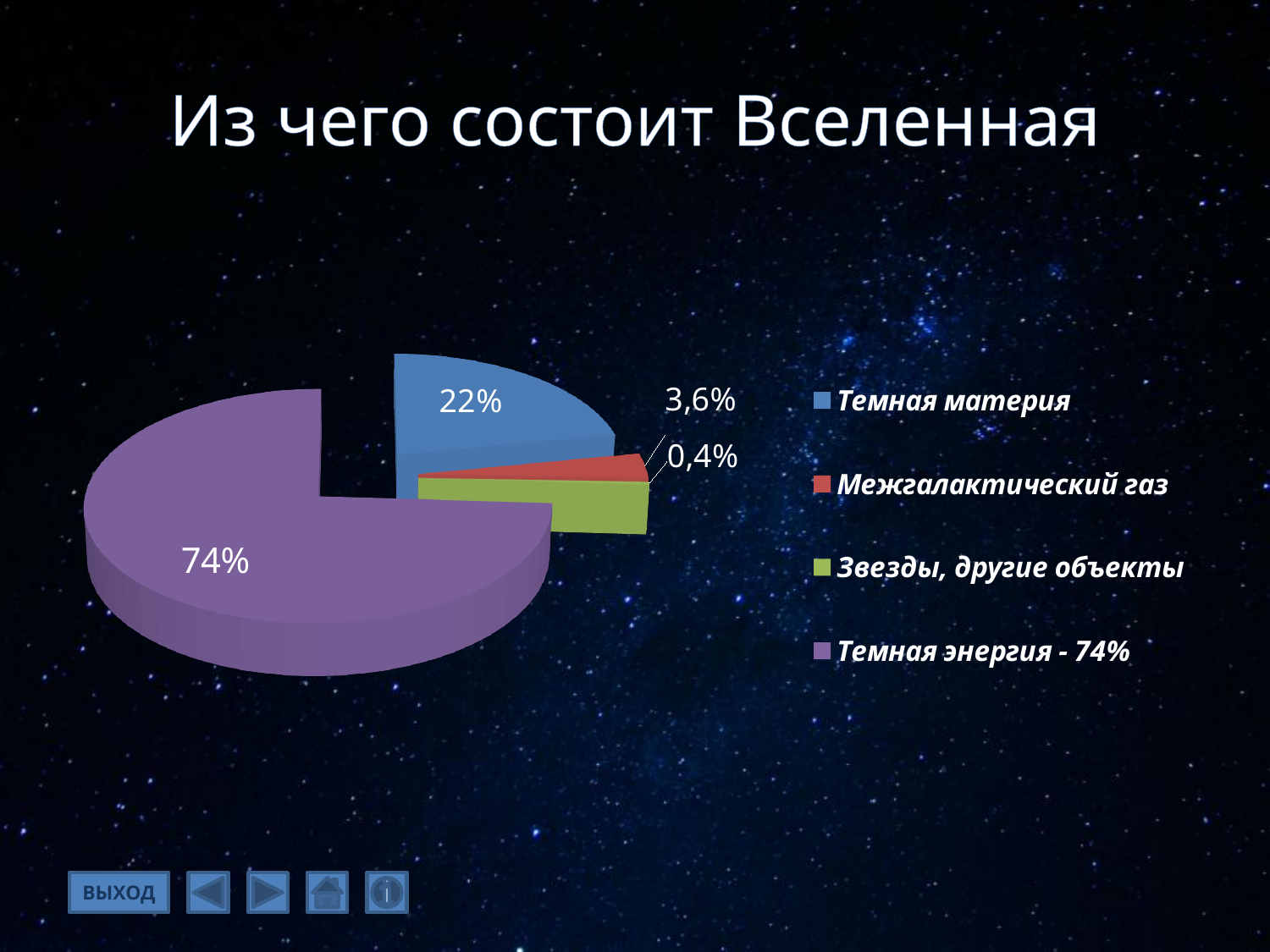
What kind of chart is shown on the slide? pie chart What share of the pie does Темная энергия take? 74% What is the difference between the values for Темная энергия and Темная материя? 52% What is the value shown for Темная материя? 22% Which category has the smallest slice of the pie? Звезды, другие объекты Which is larger, Темная материя or Межгалактический газ? Темная материя What is the title of the slide? Из чего состоит Вселенная Which category has the largest slice of the pie? Темная энергия What is the value shown for Звезды, другие объекты? 0,4% What colour is the slice for Темная энергия? purple What is the value shown for Межгалактический газ? 3,6% How many slices does the pie chart have? 4